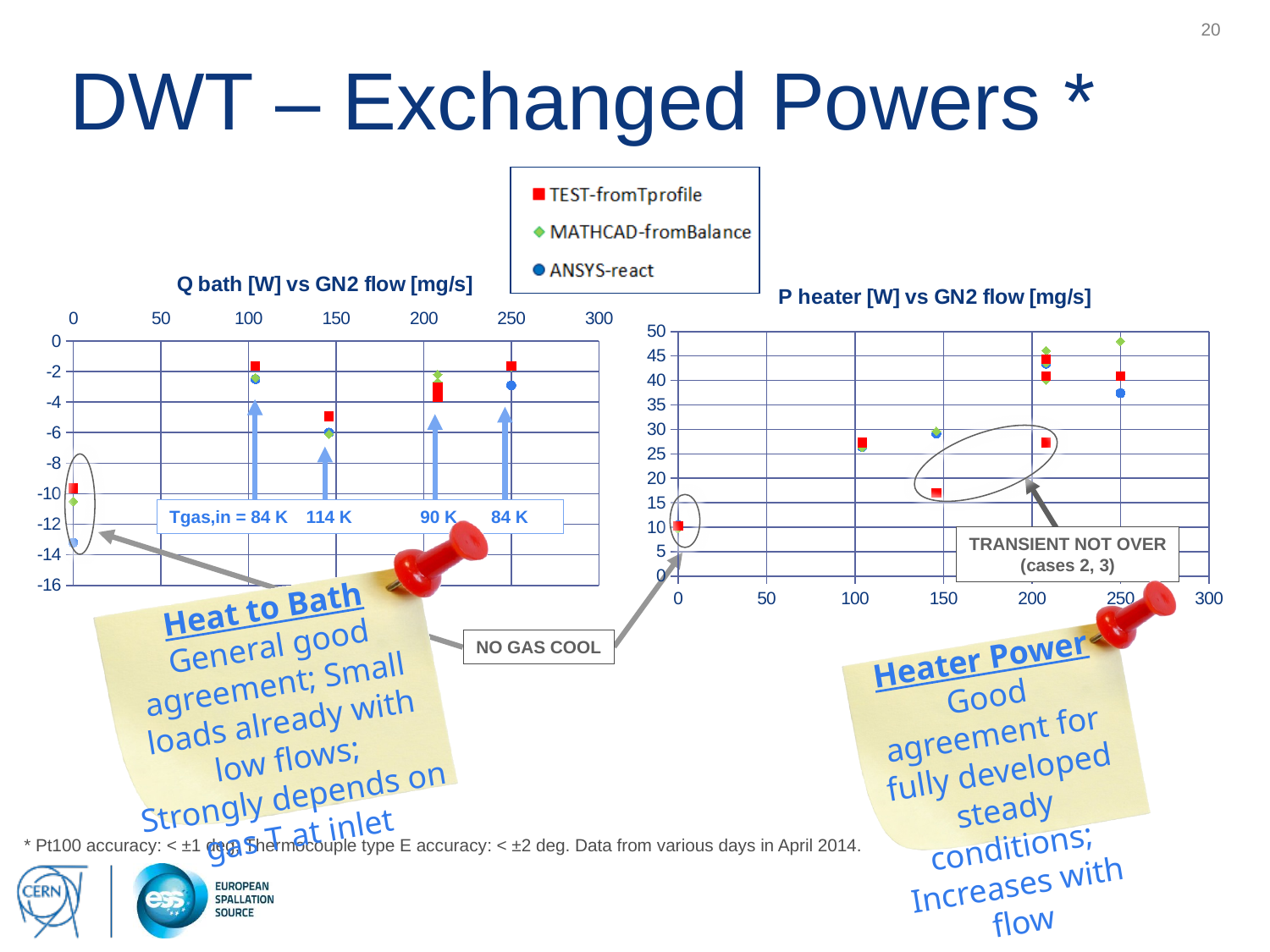
How many series does the shared legend list for the charts? 3 Which series in the legend is shown with green diamond markers? MATHCAD-fromBalance In the 'P heater [W] vs GN2 flow [mg/s]' chart, is the ANSYS-react value at a GN2 flow of about 250 mg/s greater or less than 30? greater In the 'P heater [W] vs GN2 flow [mg/s]' chart, does the heater power generally rise or fall as GN2 flow increases? rise In the 'P heater [W] vs GN2 flow [mg/s]' chart, is the TEST-fromTprofile value at a GN2 flow of 0 greater or less than 20? less In the 'P heater [W] vs GN2 flow [mg/s]' chart, at a GN2 flow of about 250 mg/s, which is larger: the MATHCAD-fromBalance value or the ANSYS-react value? MATHCAD-fromBalance In the 'P heater [W] vs GN2 flow [mg/s]' chart, at a GN2 flow of about 145 mg/s, which is larger: the TEST-fromTprofile value or the MATHCAD-fromBalance value? MATHCAD-fromBalance Which series in the legend is shown with red square markers? TEST-fromTprofile In the 'P heater [W] vs GN2 flow [mg/s]' chart, is the MATHCAD-fromBalance value at a GN2 flow of about 250 mg/s greater or less than 40? greater In the 'P heater [W] vs GN2 flow [mg/s]' chart, which series has the single highest plotted point? MATHCAD-fromBalance What kind of chart is the 'Q bath [W] vs GN2 flow [mg/s]' chart? scatter chart In the 'Q bath [W] vs GN2 flow [mg/s]' chart, how many distinct GN2 flow values have data points plotted? 5